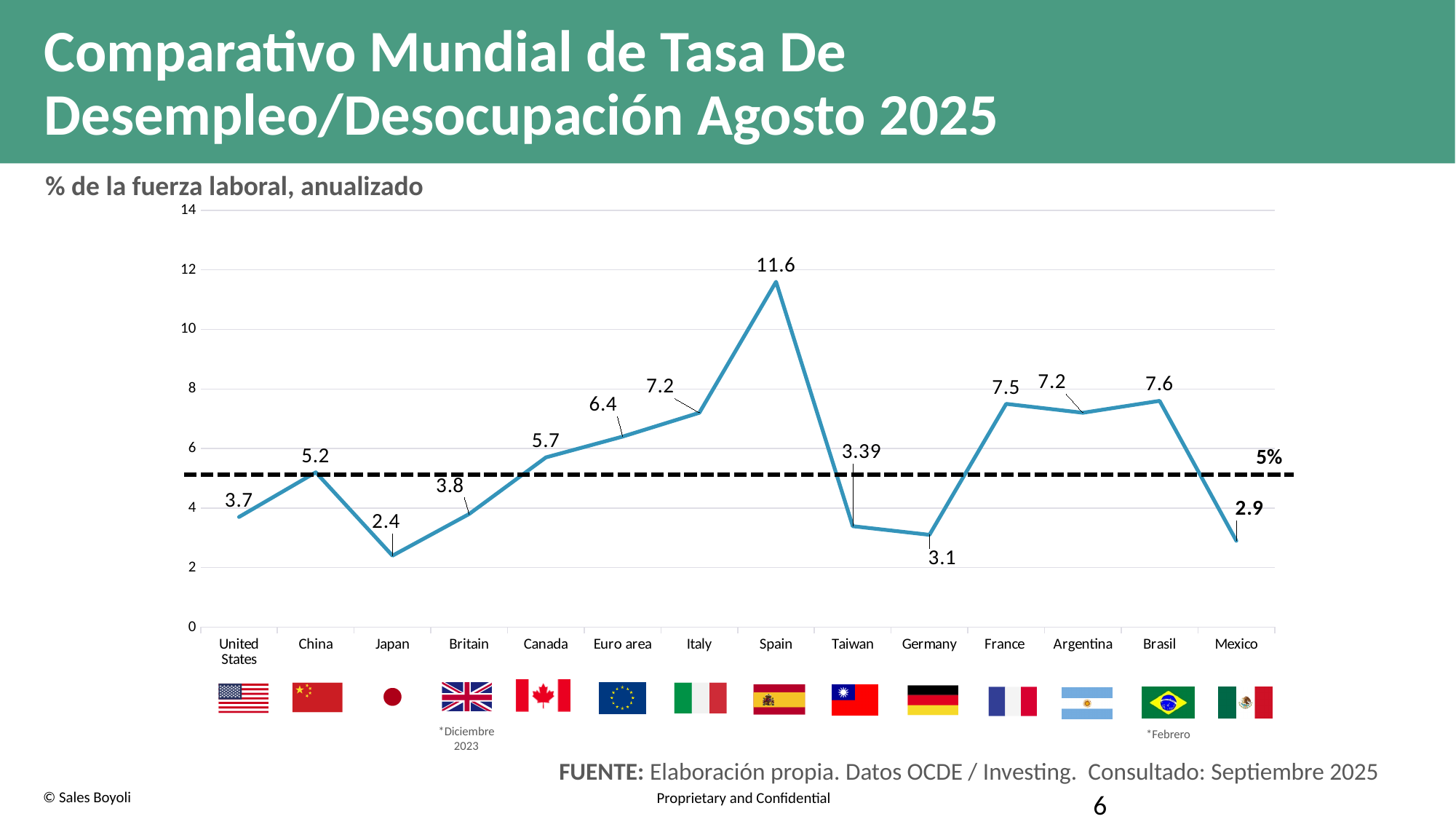
What is the difference between the values for Spain and Japan? 9.2 What value does the dashed horizontal reference line mark? 5% Which has a higher unemployment rate, Canada or Germany? Canada What is the value shown for Mexico? 2.9 What is the value plotted for Taiwan? 3.39 What is the unemployment rate shown for Spain? 11.6 What kind of chart is shown on the slide? Line chart What is the difference between the values for Brasil and France? 0.1 Which country has the highest unemployment rate on the chart? Spain Is the value for Italy greater or less than 6? greater How many countries or regions are plotted on the chart? 14 Which country has the lowest unemployment rate on the chart? Japan